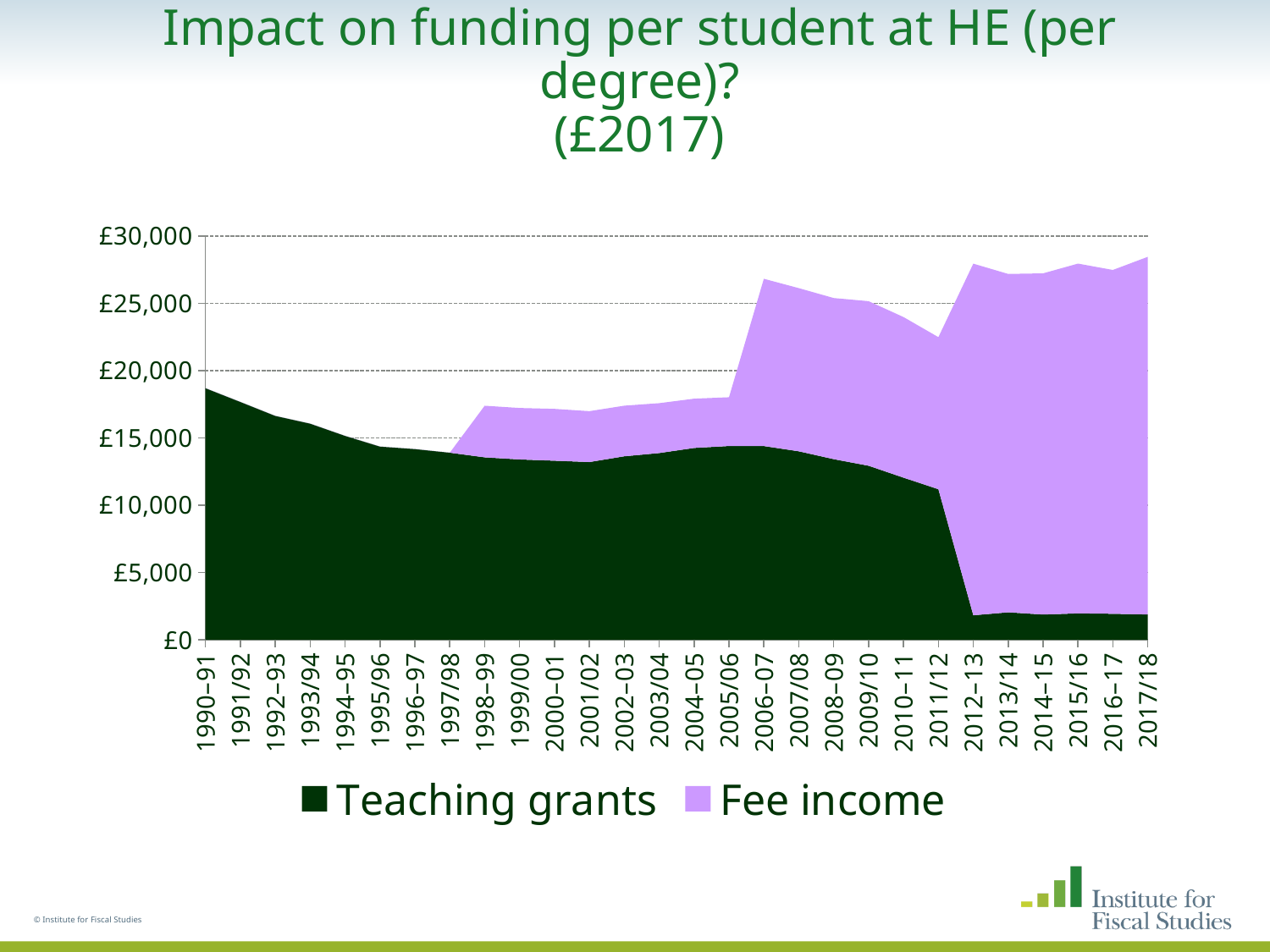
Is the total funding per student (Teaching grants plus Fee income) in 2017/18 greater or less than £25,000? greater What kind of chart is shown on the slide? Stacked area chart In which year is the Teaching grants value highest? 1990–91 Is the total funding per student in 2005/06 greater or less than £20,000? less Is the value for Teaching grants in 2011/12 greater or less than £10,000? greater What are the two series named in the legend? Teaching grants and Fee income How many series does the legend list? 2 How many academic years are shown along the x axis? 28 Which is larger: the Teaching grants value in 1990–91 or in 2017/18? 1990–91 Do Teaching grants rise or fall overall from 1990–91 to 2017/18? Fall